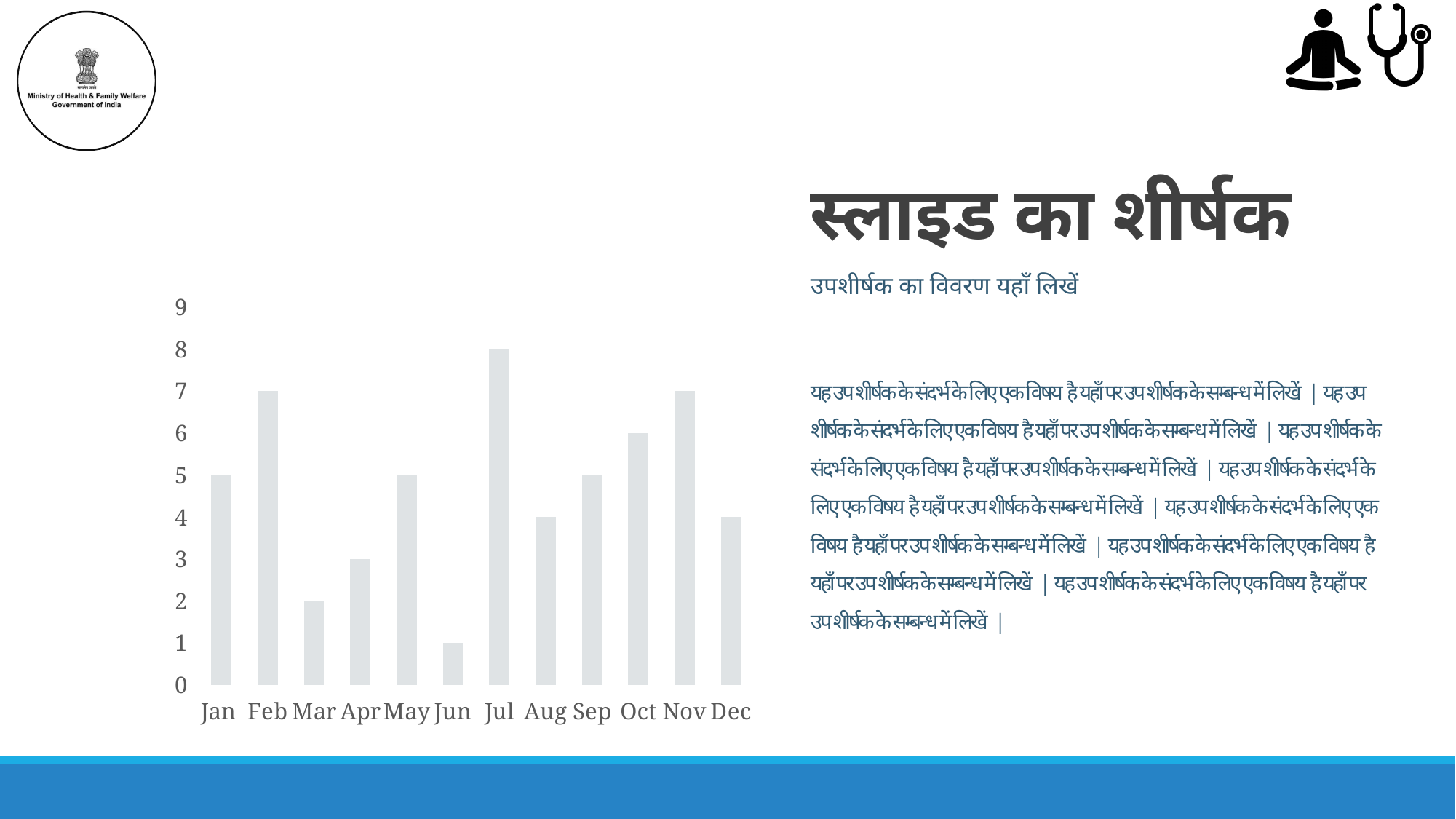
What is the difference between the values for Jul and Jun in the chart? 7 What is the value for Mar in the chart? 2 Is the value for Nov greater or less than 5? greater What is the value for Jul in the chart? 8 What is the value for Jun in the chart? 1 Which month has the highest bar in the chart? Jul Which month has the lowest bar in the chart? Jun How many months are shown on the x axis of the chart? 12 What is the value for Oct in the chart? 6 Do the values rise or fall from Mar to Apr in the chart? rise What kind of chart is shown on the slide? bar chart Which is larger in the chart, the value for Feb or the value for Apr? Feb